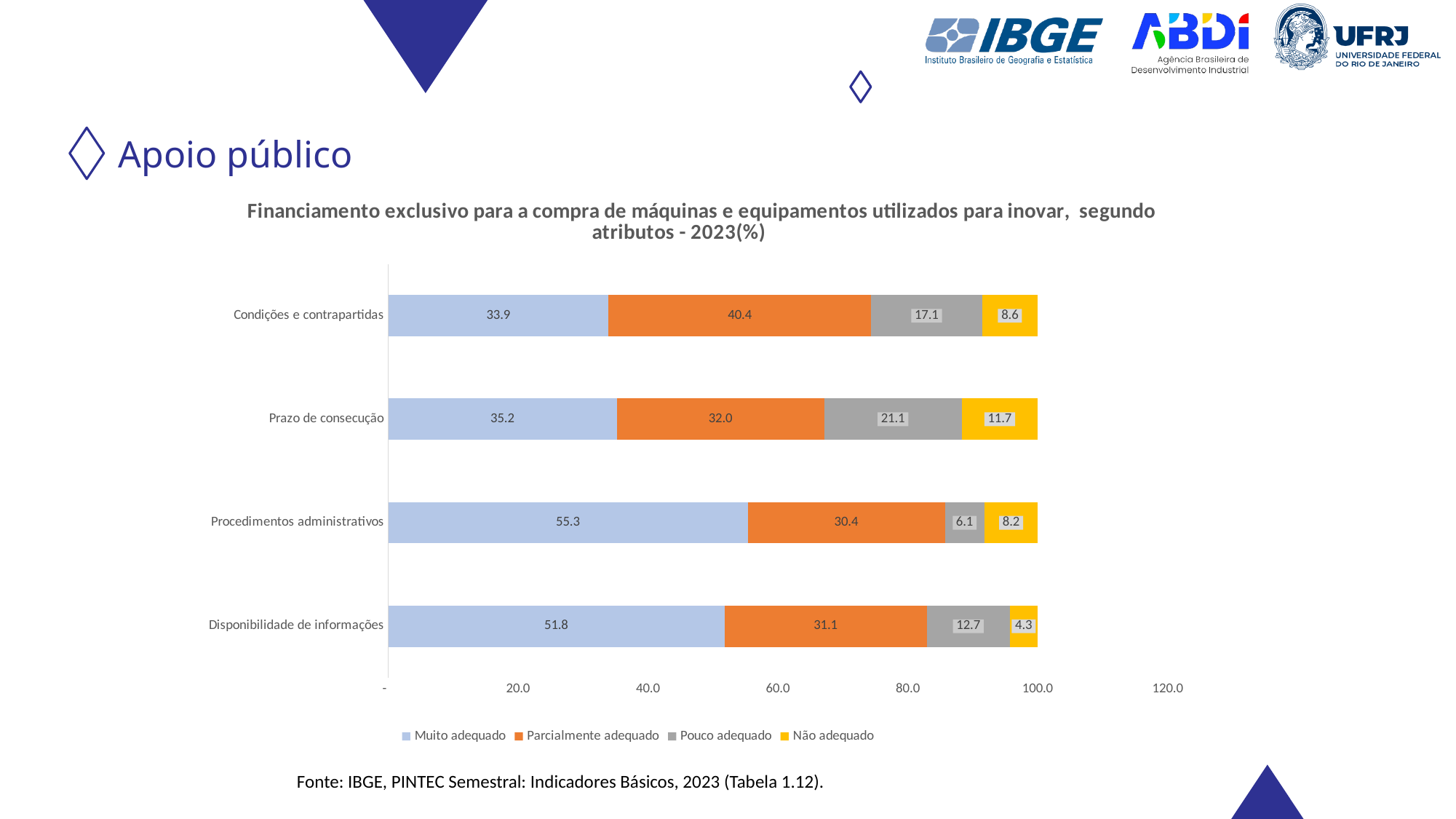
Which category has the lowest 'Pouco adequado' value? Procedimentos administrativos How many series does the legend list? 4 What is the difference between the 'Parcialmente adequado' values for Condições e contrapartidas and Prazo de consecução? 8.4 How many categories (attributes) are shown on the chart? 4 What is the total of the stacked bar for Procedimentos administrativos? 100.0 Which series is shown in orange in the legend? Parcialmente adequado Which category has the highest 'Muito adequado' value? Procedimentos administrativos What is the 'Muito adequado' value for Procedimentos administrativos? 55.3 What is the 'Pouco adequado' value for Disponibilidade de informações? 12.7 Which is larger: the 'Muito adequado' value for Prazo de consecução or for Condições e contrapartidas? Prazo de consecução What is the 'Não adequado' value for Prazo de consecução? 11.7 What type of chart is shown on the slide? Stacked bar chart